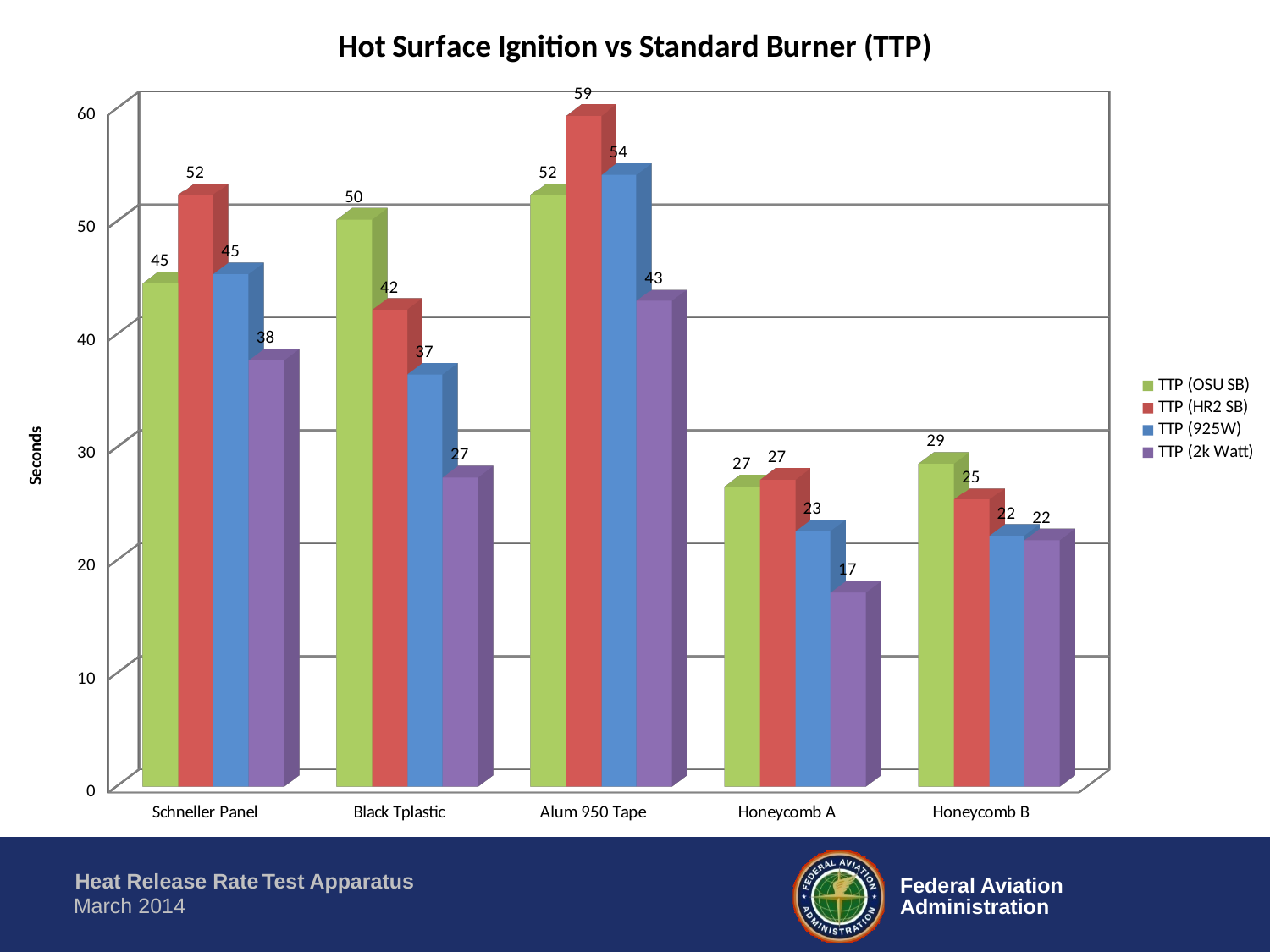
Which category has the lowest TTP (2k Watt) value? Honeycomb A What is the TTP (HR2 SB) value for Alum 950 Tape? 59 How many categories are shown on the x axis? 5 What is the label on the vertical axis? Seconds How many series does the legend list? 4 Which category has the highest TTP (OSU SB) value? Alum 950 Tape Which is larger for Honeycomb B: TTP (OSU SB) or TTP (HR2 SB)? TTP (OSU SB) What is the TTP (2k Watt) value for Honeycomb A? 17 What is the TTP (925W) value for Black Tplastic? 37 What is the title of the chart? Hot Surface Ignition vs Standard Burner (TTP) What is the difference between the TTP (HR2 SB) and TTP (2k Watt) values for Schneller Panel? 14 What kind of chart is shown on the slide? Bar chart